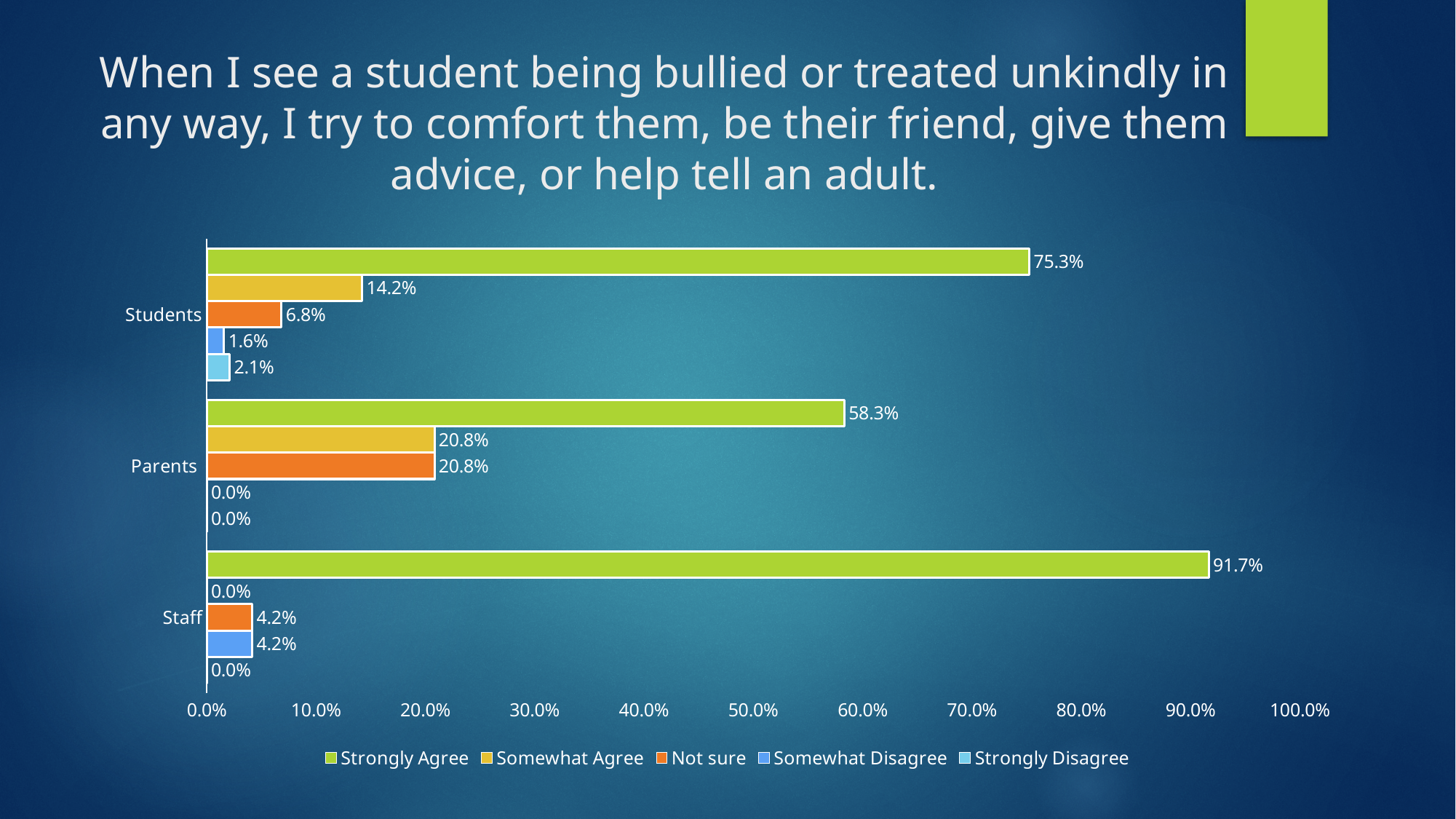
What kind of chart is shown on the slide? Bar chart What percentage of Parents responded "Not sure"? 20.8% Which group has the highest "Strongly Agree" percentage? Staff Which group has the lowest "Strongly Agree" percentage? Parents How many series does the legend list? 5 What is the difference between the "Strongly Agree" percentages for Staff and Students? 16.4% What percentage of Students responded "Strongly Agree"? 75.3% How many groups (categories) are shown on the chart? 3 What percentage of Students responded "Somewhat Disagree"? 1.6% Which legend entry is shown in green? Strongly Agree What percentage of Staff responded "Strongly Agree"? 91.7% Which is larger: the "Somewhat Agree" percentage for Students or for Parents? Parents